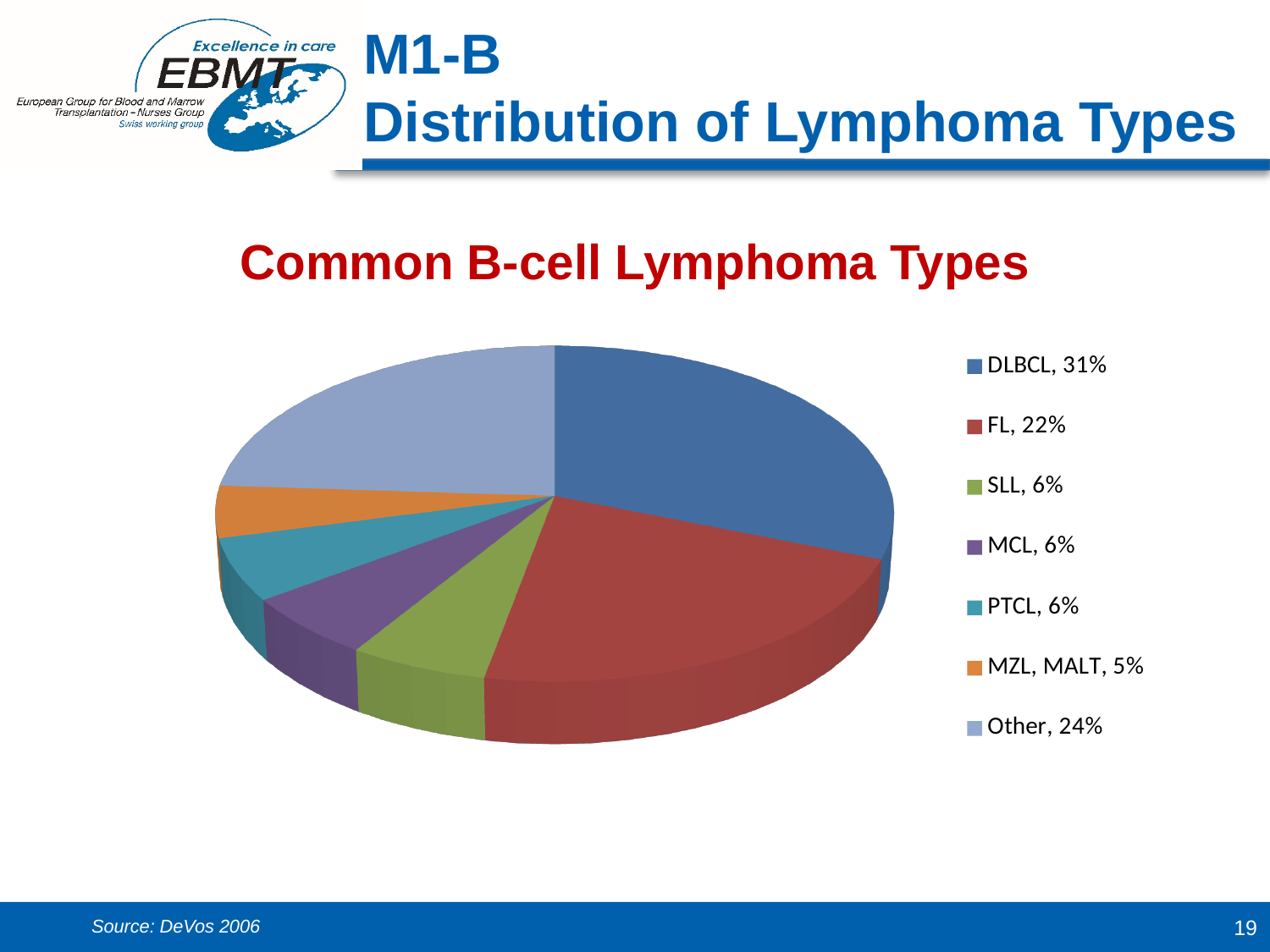
What share of the pie does FL represent? 22% Which is larger, the share for FL or the share for Other? Other Which lymphoma type has the largest slice of the pie? DLBCL What share of the pie does Other represent? 24% What share of the pie does MZL, MALT represent? 5% Which lymphoma type has the smallest slice of the pie? MZL, MALT What is the title of the chart? Common B-cell Lymphoma Types What is the difference in percentage points between Other and FL? 2 What is the difference in percentage points between DLBCL and FL? 9 What kind of chart is shown on the slide? Pie chart What share of the pie does DLBCL represent? 31% How many slices does the pie chart have? 7